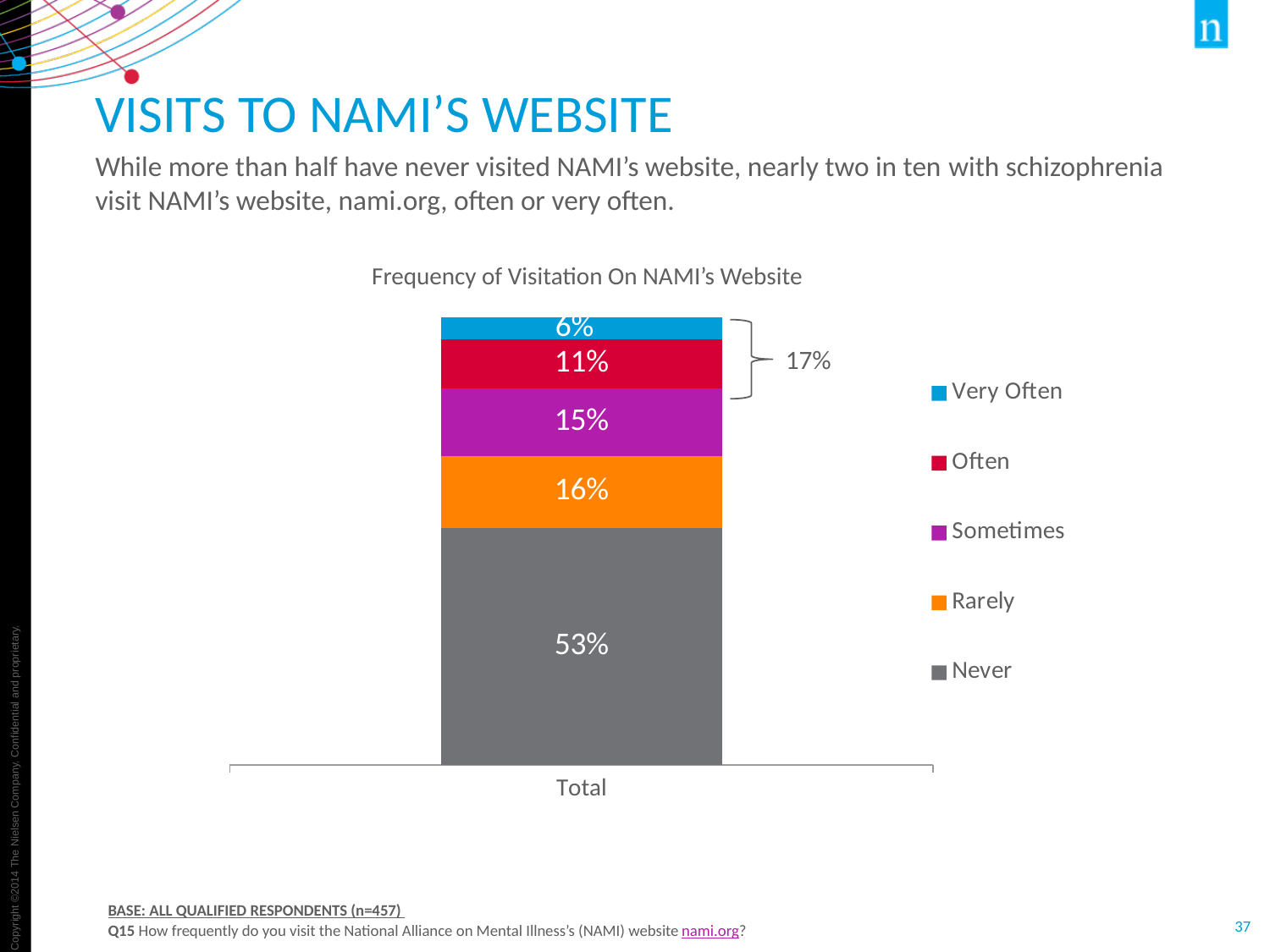
Which visitation frequency category has the smallest share? Very Often Which is larger, the share for Sometimes or the share for Often? Sometimes What percentage of respondents visit NAMI's website very often? 6% What percentage of respondents say they never visit NAMI's website? 53% How many series does the legend list? 5 Which visitation frequency category has the largest share? Never What is the title of the chart? Frequency of Visitation On NAMI's Website What percentage of respondents visit NAMI's website often? 11% What is the difference in percentage points between Never and Rarely? 37 What kind of chart is shown on the slide? Stacked bar chart What is the combined percentage for Often and Very Often shown by the bracket? 17% What percentage of respondents visit NAMI's website rarely? 16%